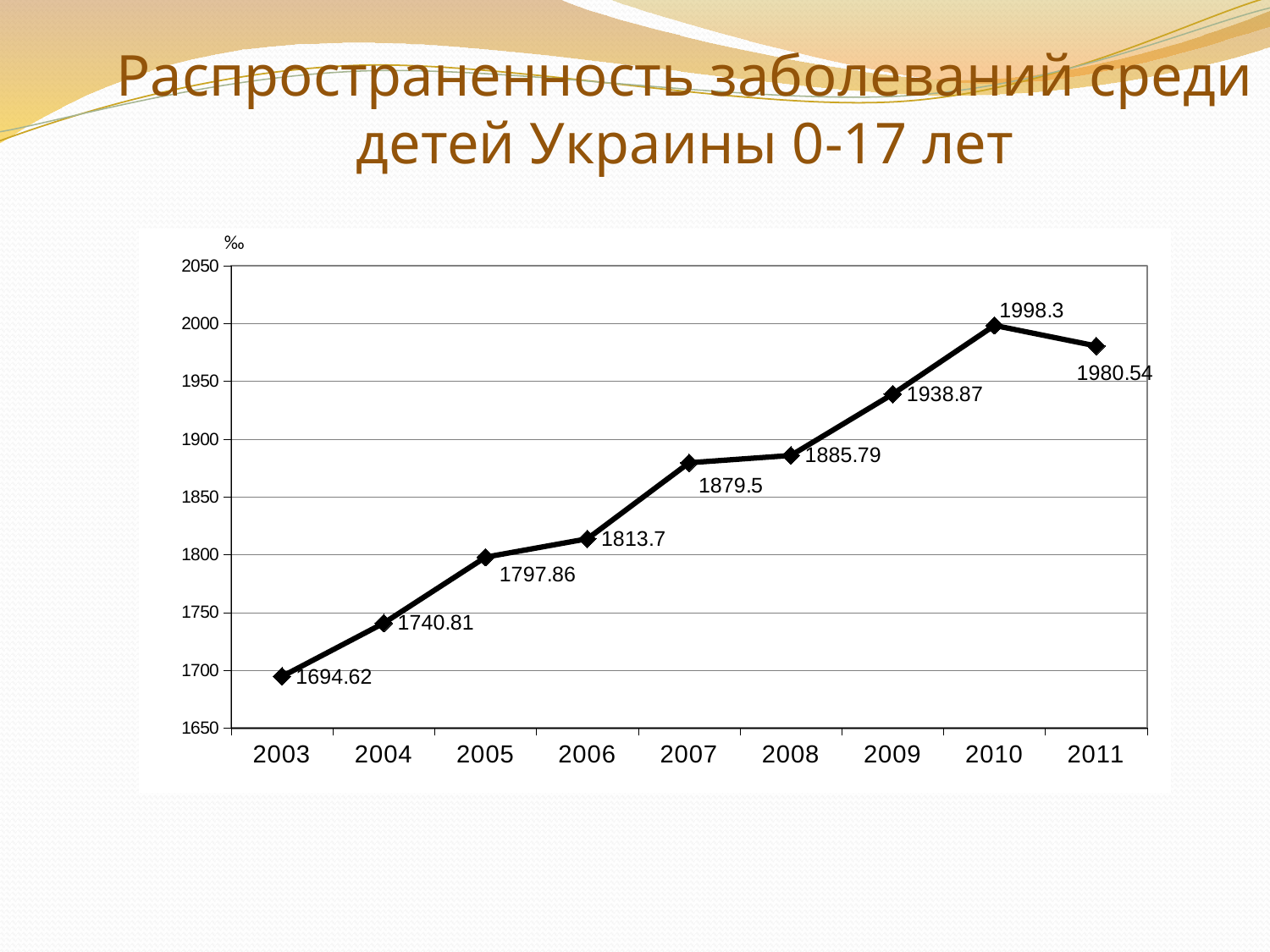
What is the value for 2003? 1694.62 What is the value for 2011? 1980.54 What is the value for 2007? 1879.5 Which year has the lowest value? 2003 What is the difference between the values for 2004 and 2003? 46.19 How many years are plotted on the x axis? 9 Do the values generally rise or fall from 2003 to 2010? rise Which is larger, the value for 2009 or the value for 2008? 2009 Which year has the highest value? 2010 What kind of chart is shown on the slide? line chart What is the difference between the values for 2010 and 2011? 17.76 Is the value for 2006 greater or less than 1800? greater